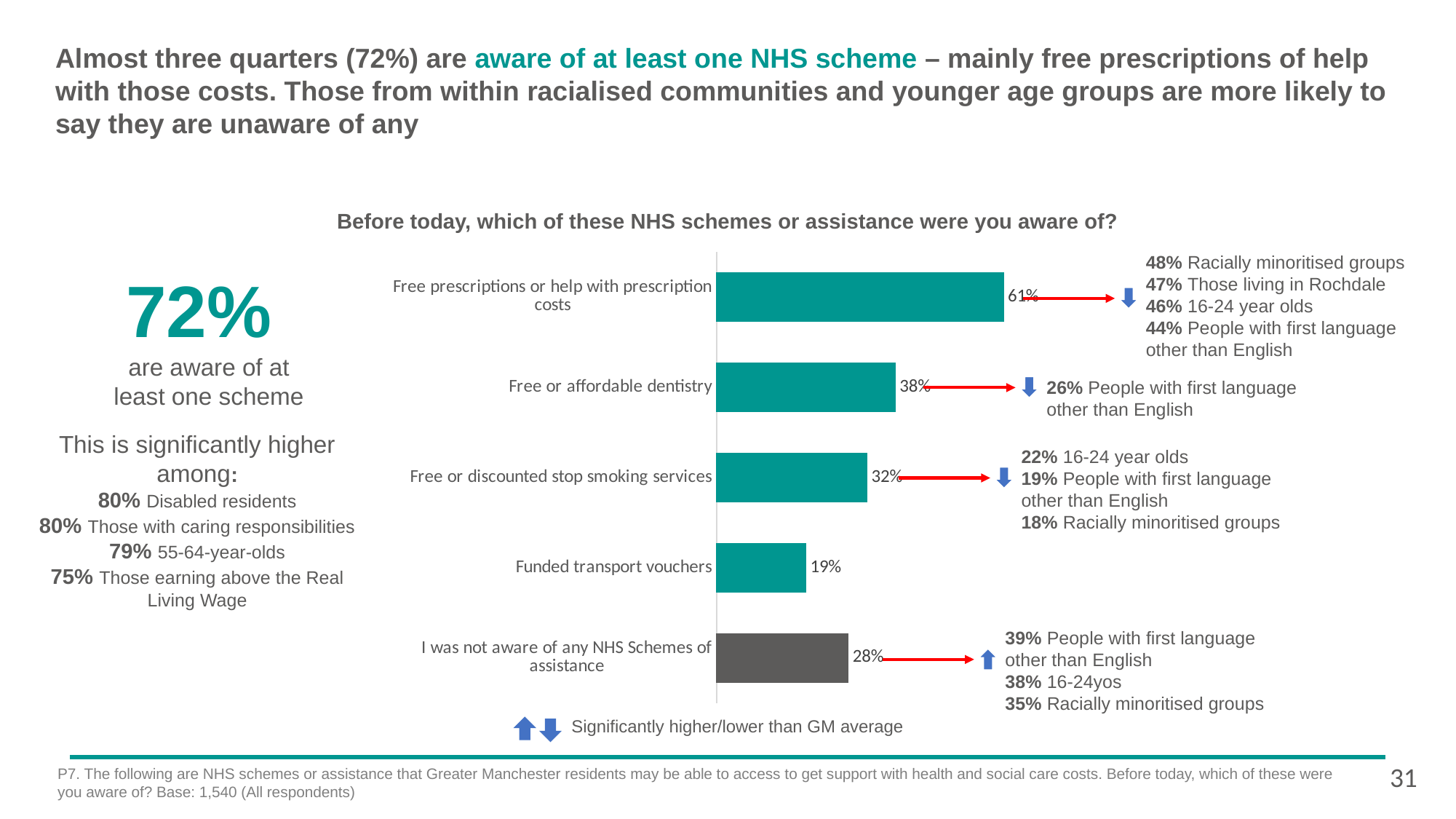
What percentage of respondents were aware of funded transport vouchers? 19% What is the difference in awareness between free or affordable dentistry and free or discounted stop smoking services? 6 percentage points What percentage of respondents said they were not aware of any NHS schemes of assistance? 28% Which is larger: awareness of free or discounted stop smoking services or the share not aware of any NHS schemes? Free or discounted stop smoking services Which NHS scheme had the highest awareness? Free prescriptions or help with prescription costs How many categories are shown in the chart? 5 What percentage of respondents were aware of free prescriptions or help with prescription costs? 61% Which bar in the chart is coloured dark grey rather than teal? I was not aware of any NHS Schemes of assistance What type of chart is shown on the slide? Bar chart Which category has the lowest value in the chart? Funded transport vouchers What is the title of the chart? Before today, which of these NHS schemes or assistance were you aware of? What percentage of respondents were aware of free or affordable dentistry? 38%